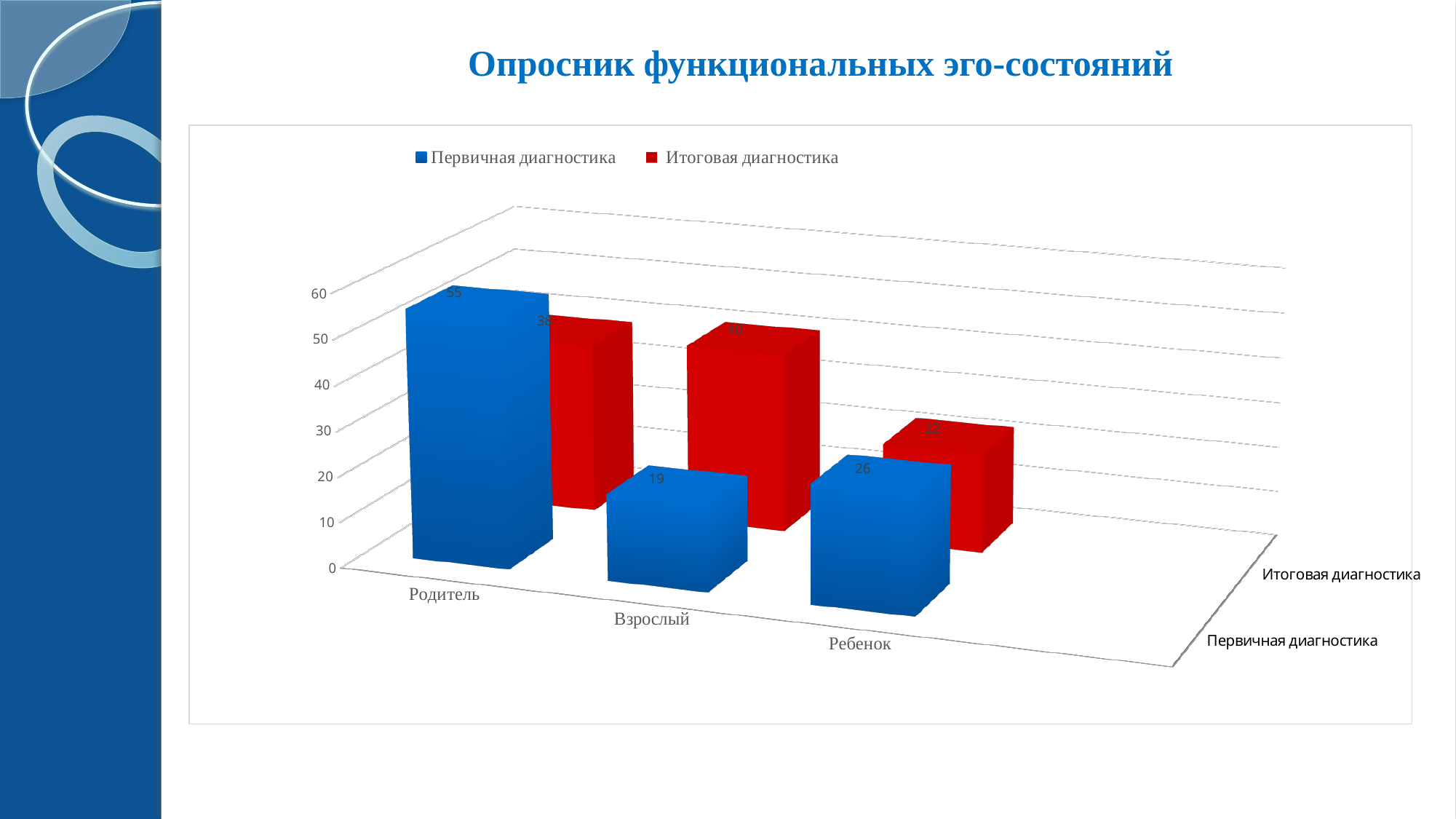
Which is larger for Ребенок: the Первичная диагностика value or the Итоговая диагностика value? Первичная диагностика What is the value for Ребенок in the Итоговая диагностика series? 22 Is the Итоговая диагностика value for Взрослый greater or less than 30? greater Which category has the highest value in the Первичная диагностика series? Родитель Which category has the lowest value in the Первичная диагностика series? Взрослый What is the value for Родитель in the Итоговая диагностика series? 38 What is the value for Взрослый in the Первичная диагностика series? 19 How many categories are shown on the x axis? 3 How many series does the legend list? 2 What is the value for Родитель in the Первичная диагностика series? 55 What is the difference between the Первичная диагностика and Итоговая диагностика values for Родитель? 17 What is the value for Ребенок in the Первичная диагностика series? 26